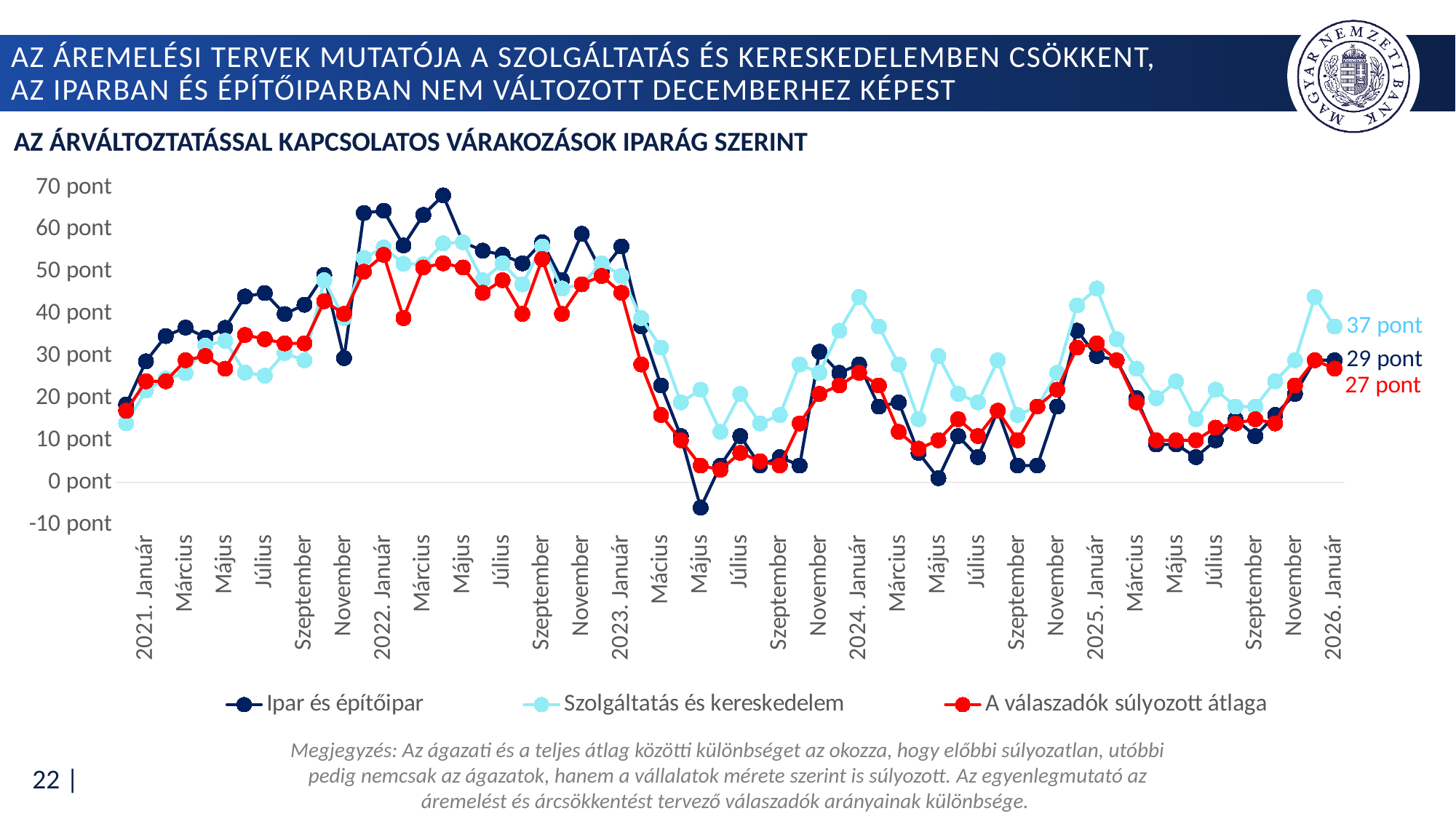
How many series does the legend list? 3 In 2026. Január, how much higher is Szolgáltatás és kereskedelem than Ipar és építőipar? 8 pont Which series has the lowest value in 2026. Január? A válaszadók súlyozott átlaga What kind of chart is shown on the slide? Line chart Is the value for Ipar és építőipar in 2022. Május greater or less than 60 pont? less What is the value for Szolgáltatás és kereskedelem in 2026. Január? 37 pont Is the value for Ipar és építőipar in 2023. Május greater or less than 0 pont? less In 2026. Január, what is the difference between Ipar és építőipar and A válaszadók súlyozott átlaga? 2 pont Which series has the highest value in 2026. Január? Szolgáltatás és kereskedelem What is the title of the chart? AZ ÁRVÁLTOZTATÁSSAL KAPCSOLATOS VÁRAKOZÁSOK IPARÁG SZERINT What is the value for A válaszadók súlyozott átlaga in 2026. Január? 27 pont What is the value for Ipar és építőipar in 2026. Január? 29 pont